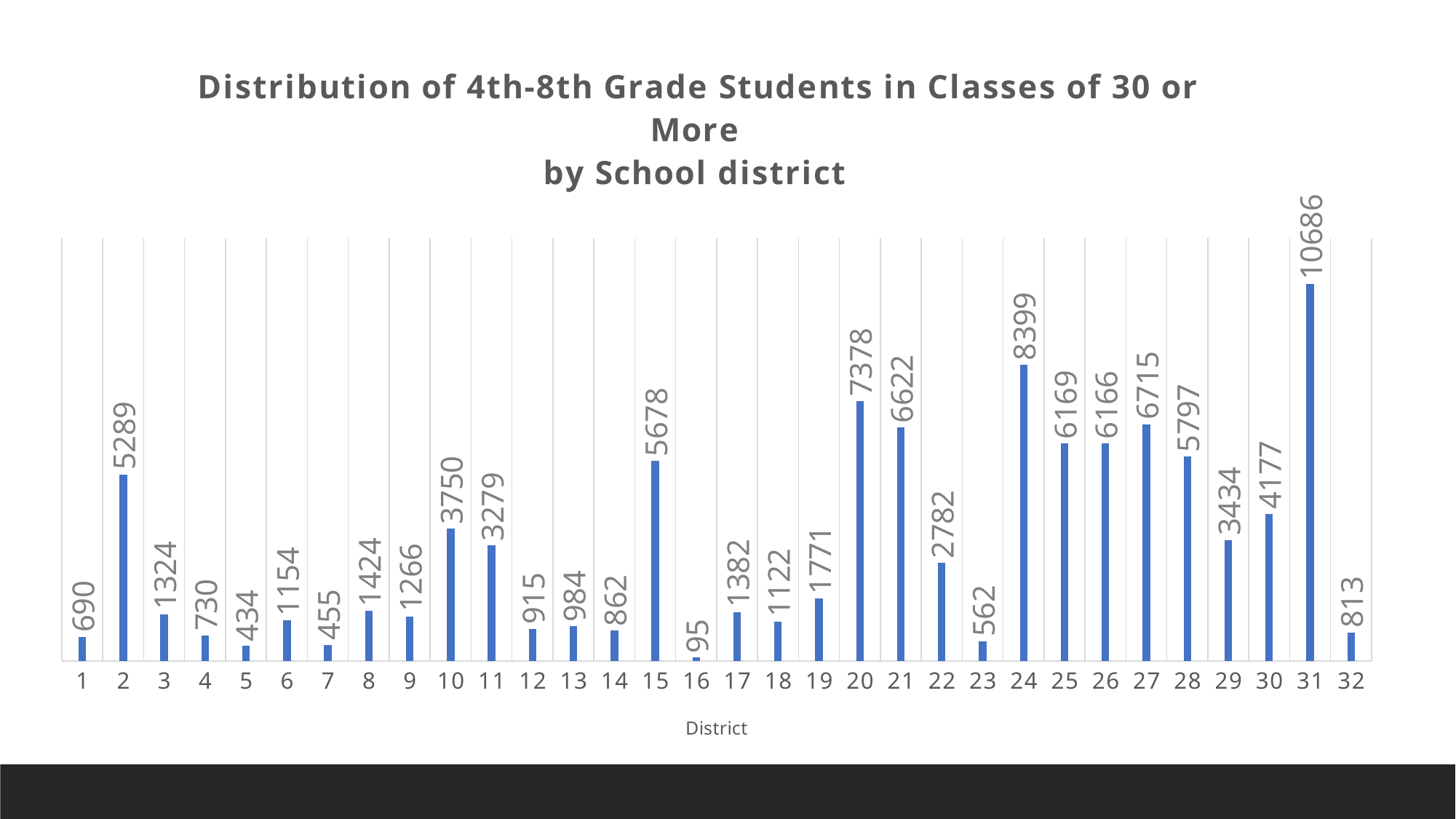
What is the value for district 24? 8399 What is the value for district 10? 3750 What is the difference between the values for district 10 and district 11? 471 Which district has the lowest value? 16 How many districts are shown on the x axis? 32 What is the label of the x axis? District Which has a larger value, district 20 or district 21? district 20 What is the value for district 31? 10686 What kind of chart is this? bar chart What is the value for district 16? 95 Which district has the highest value? 31 What is the difference between the values for district 31 and district 24? 2287